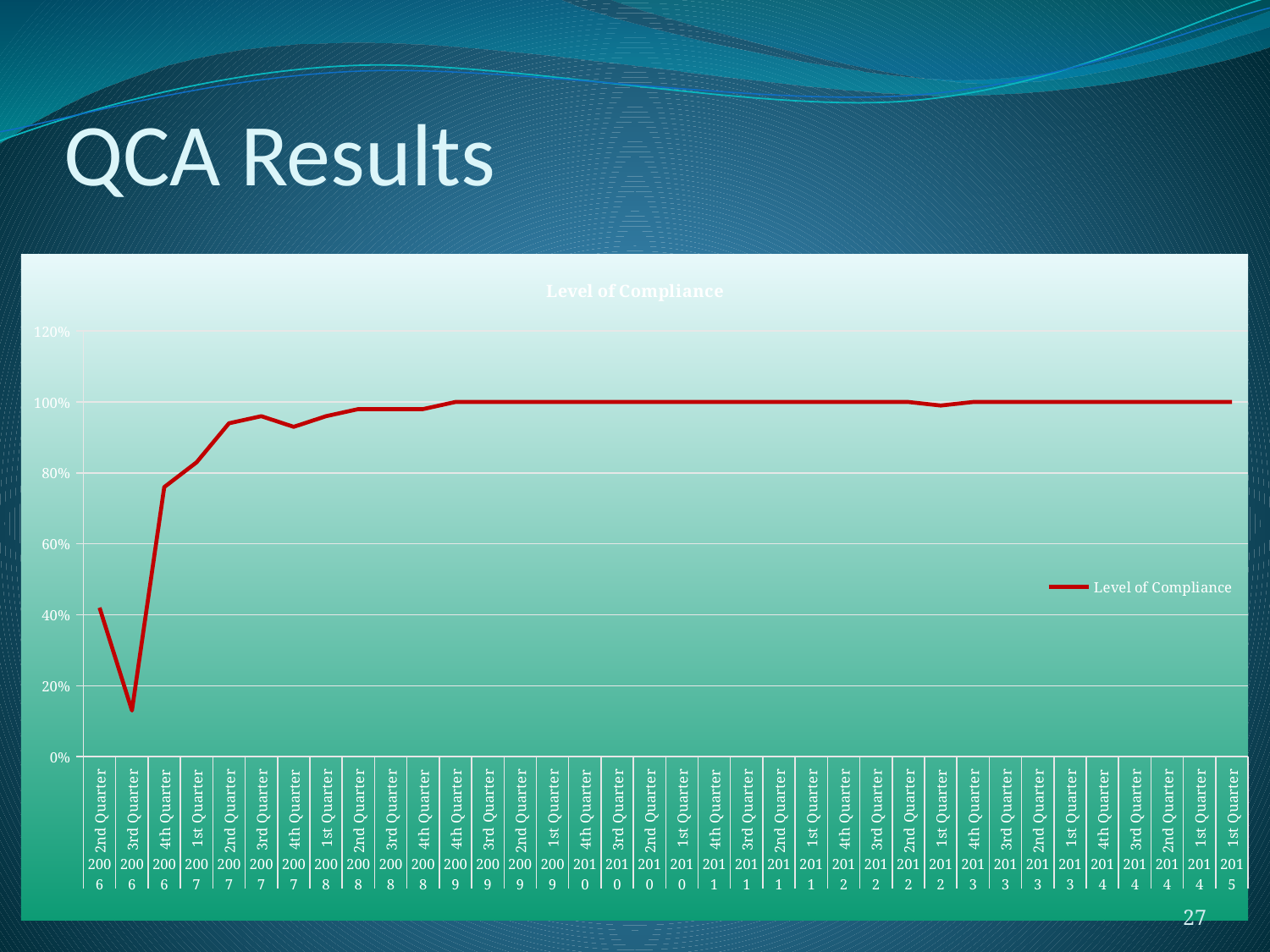
How many series does the legend list? 1 What kind of chart is shown on the slide? line chart How many quarters are plotted on the x axis? 36 Is the value for 3rd Quarter 2006 greater or less than 20%? less Which quarter has the lowest level of compliance? 3rd Quarter 2006 Is the value for 2nd Quarter 2007 greater or less than 80%? greater What is the title of the chart? Level of Compliance Which is larger, the value for 2nd Quarter 2006 or the value for 4th Quarter 2006? 4th Quarter 2006 What is the first category on the x axis? 2nd Quarter 2006 Is the value for 4th Quarter 2006 greater or less than 60%? greater Does the level of compliance rise or fall between 3rd Quarter 2006 and 4th Quarter 2006? rise